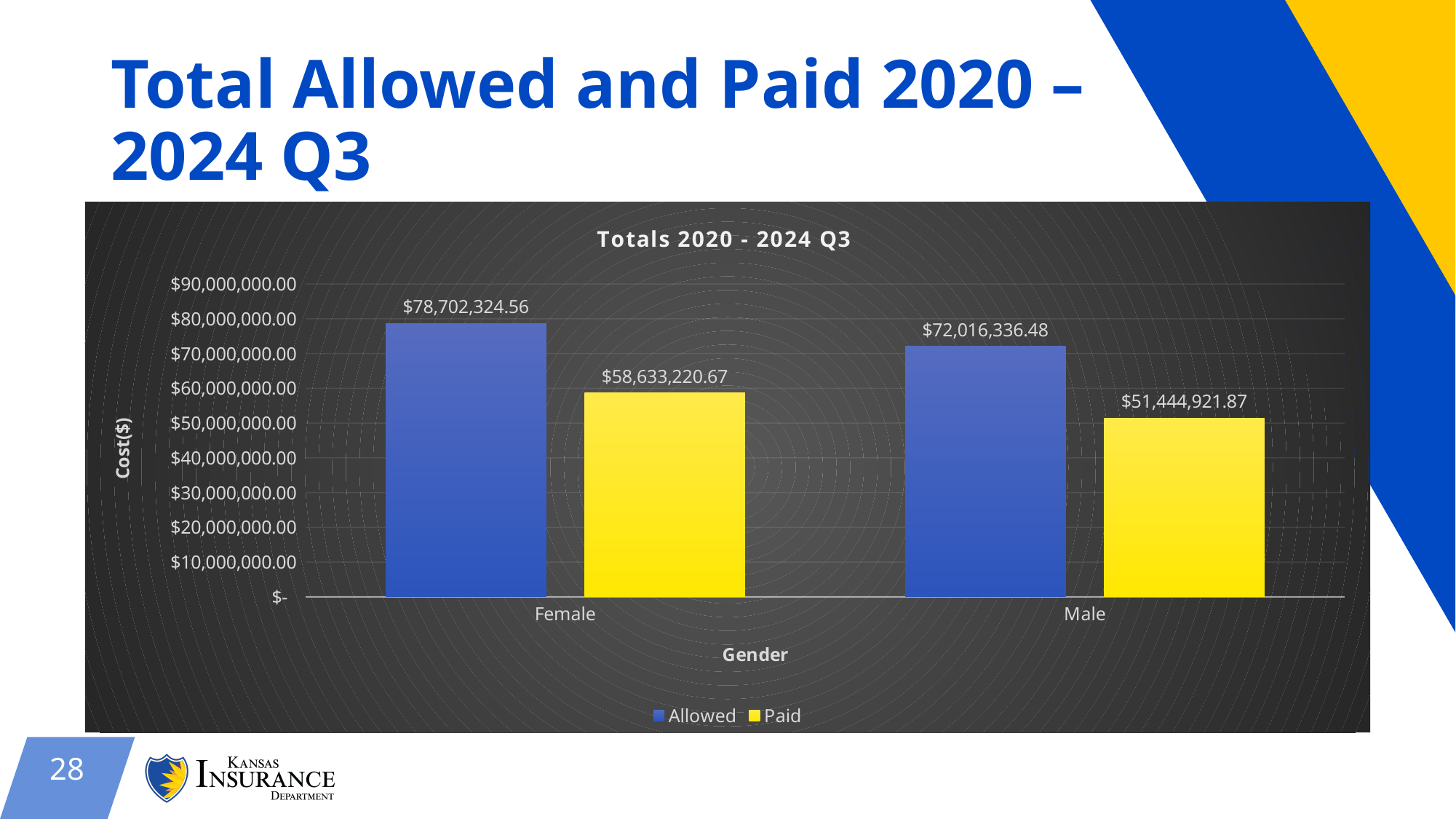
Which bar shows the lowest value on the chart? Male Paid What is the Paid value for Male? $51,444,921.87 How many series does the legend list? 2 What is the Allowed value for Female? $78,702,324.56 Which gender has the higher Allowed value? Female Is the Paid value for Female larger or smaller than the Paid value for Male? larger What is the title of the chart? Totals 2020 - 2024 Q3 What is the Paid value for Female? $58,633,220.67 What is the Allowed value for Male? $72,016,336.48 What kind of chart is shown on the slide? bar chart What is the difference between the Allowed values for Female and Male? $6,685,988.08 What is the difference between the Allowed and Paid values for Female? $20,069,103.89